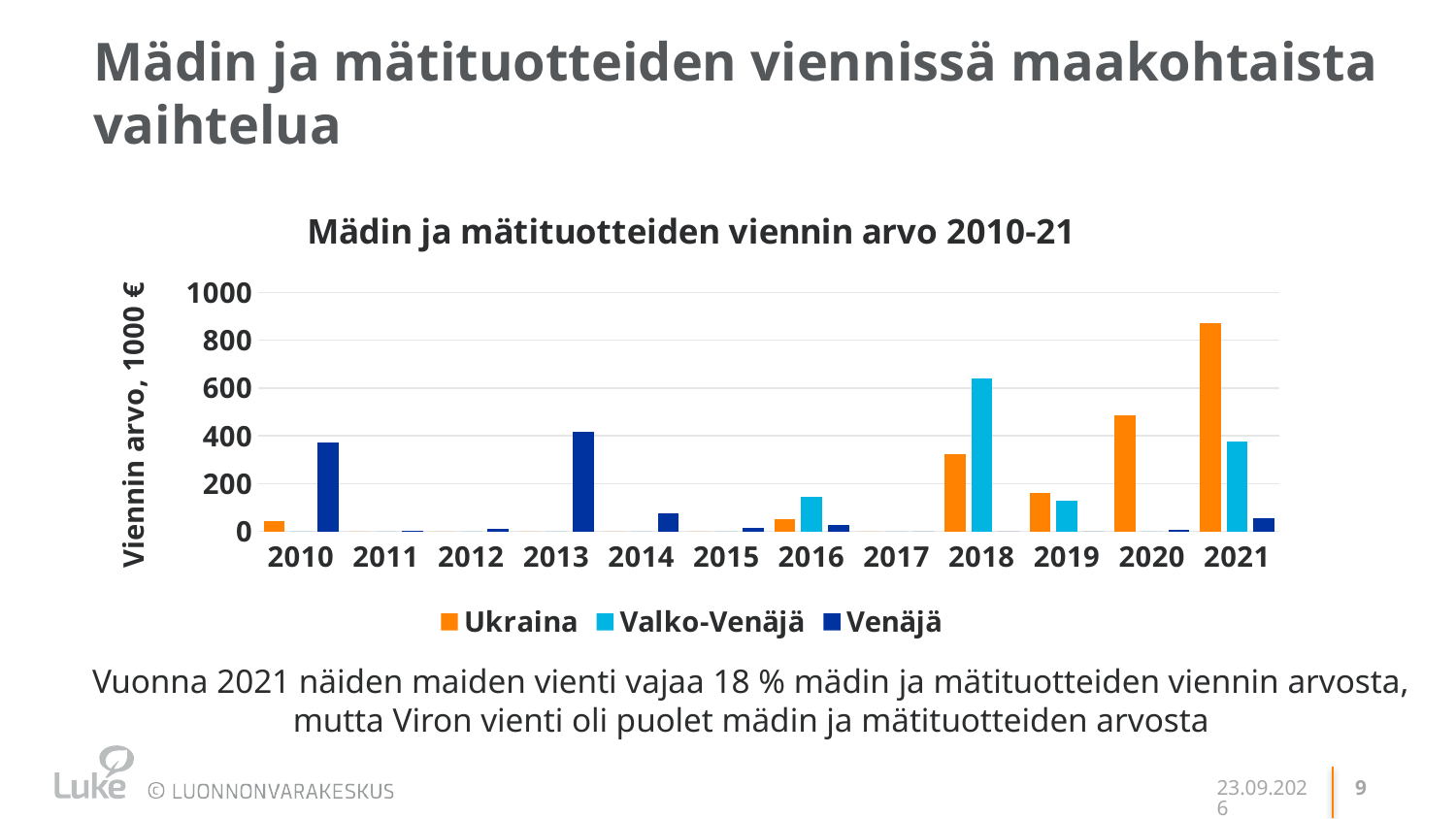
What is the title of the chart? Mädin ja mätituotteiden viennin arvo 2010-21 In which year is the Ukraina bar highest? 2021 Is the value for Ukraina in 2020 greater or less than 600? less In which year is the Venäjä bar highest? 2013 In 2021, which is larger: Ukraina or Venäjä? Ukraina Is the value for Ukraina in 2021 greater or less than 800? greater In 2018, which is larger: Ukraina or Valko-Venäjä? Valko-Venäjä How many series does the legend list? 3 Is the value for Valko-Venäjä in 2018 greater or less than 600? greater In which year is the Valko-Venäjä bar highest? 2018 What kind of chart is shown on the slide? bar chart How many years are shown on the x axis? 12